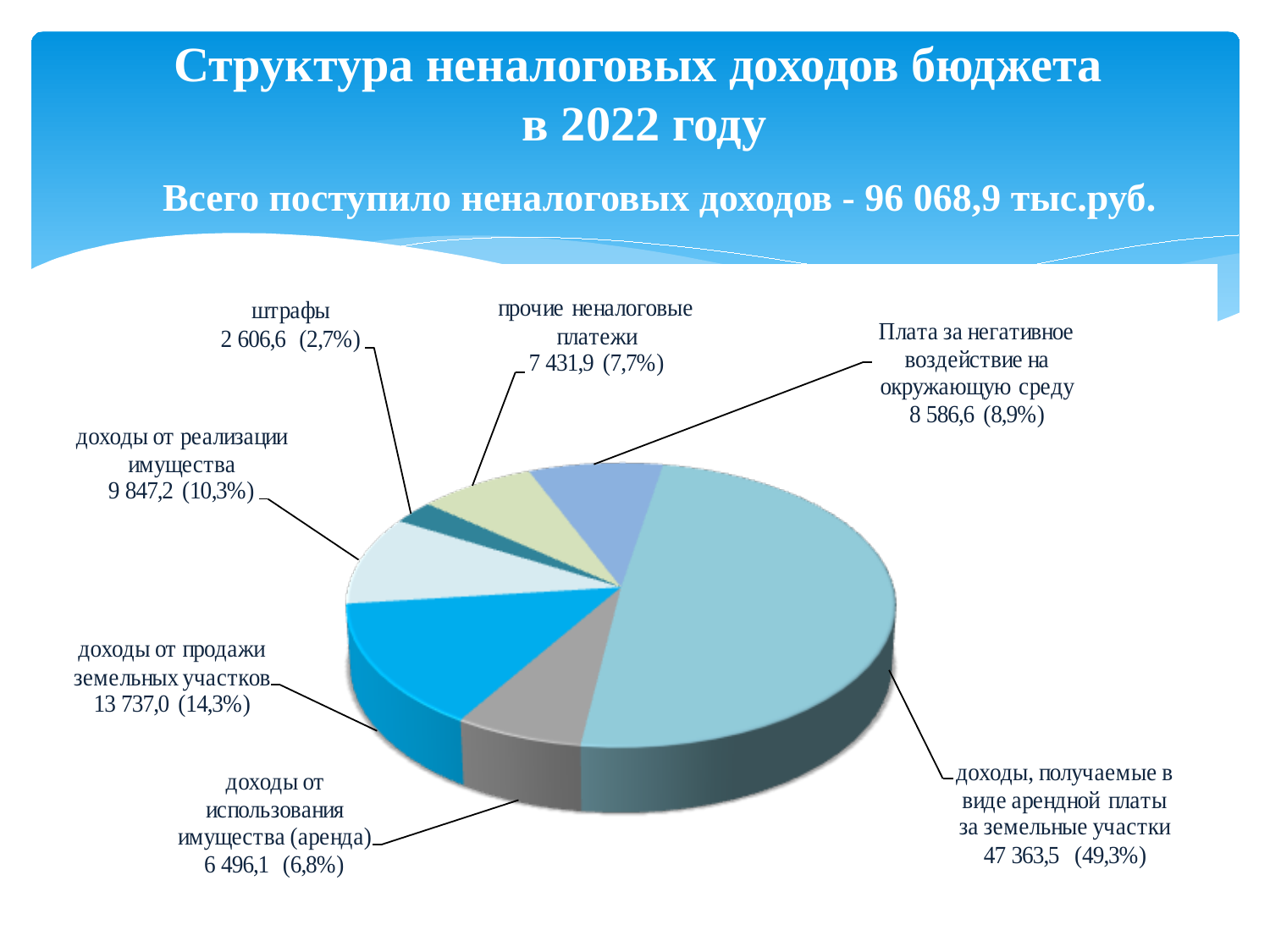
Which category has the smallest slice of the pie? штрафы What share of the pie does "доходы, получаемые в виде арендной платы за земельные участки" represent? 49,3% Which is larger: the value for "прочие неналоговые платежи" or the value for "доходы от использования имущества (аренда)"? прочие неналоговые платежи What total amount of non-tax revenue is stated in the chart's subtitle? 96 068,9 тыс.руб. Which category has the largest slice of the pie? доходы, получаемые в виде арендной платы за земельные участки What kind of chart is shown on the slide? Pie chart What share of the pie does "доходы от реализации имущества" represent? 10,3% What is the difference between the values for "доходы от продажи земельных участков" and "доходы от использования имущества (аренда)"? 7 240,9 What is the value shown for "штрафы"? 2 606,6 What is the value shown for "Плата за негативное воздействие на окружающую среду"? 8 586,6 What is the value shown for "доходы от продажи земельных участков"? 13 737,0 How many slices does the pie chart have? 7